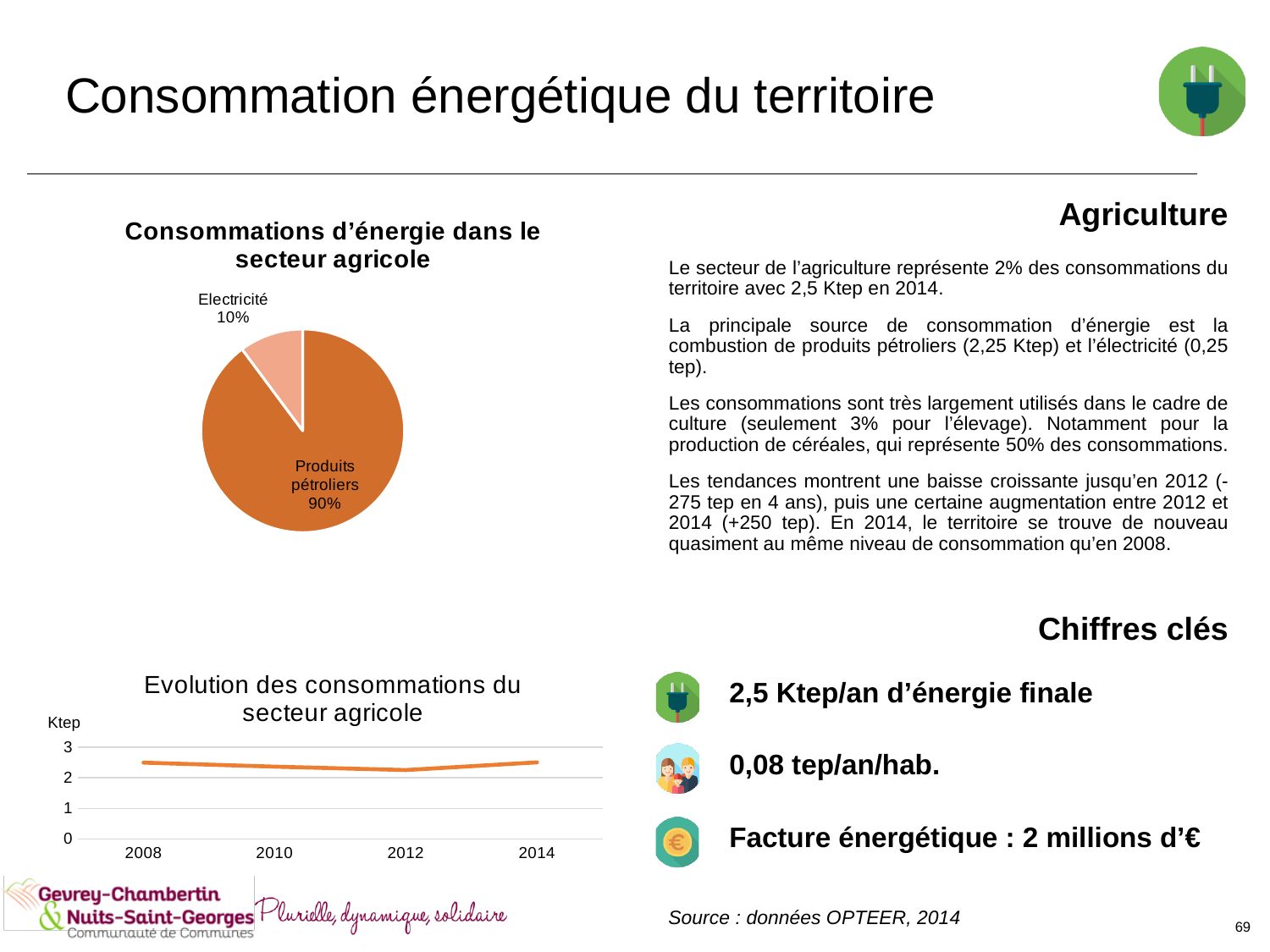
In the chart 'Evolution des consommations du secteur agricole', what unit is shown on the y axis? Ktep In the pie chart 'Consommations d'énergie dans le secteur agricole', what is the difference in percentage points between Produits pétroliers and Electricité? 80 In the chart 'Evolution des consommations du secteur agricole', how many years are shown on the x axis? 4 In the pie chart 'Consommations d'énergie dans le secteur agricole', how many slices are there? 2 What type of chart is 'Evolution des consommations du secteur agricole'? line chart In the chart 'Evolution des consommations du secteur agricole', is the value for 2012 greater or less than 3? less In the pie chart 'Consommations d'énergie dans le secteur agricole', which category has the largest share? Produits pétroliers In the pie chart 'Consommations d'énergie dans le secteur agricole', what share is Produits pétroliers? 90% In the pie chart 'Consommations d'énergie dans le secteur agricole', what share is Electricité? 10% In the pie chart 'Consommations d'énergie dans le secteur agricole', which category has the smallest share? Electricité What type of chart is 'Consommations d'énergie dans le secteur agricole'? pie chart In the chart 'Evolution des consommations du secteur agricole', is the value for 2008 greater or less than 2? greater